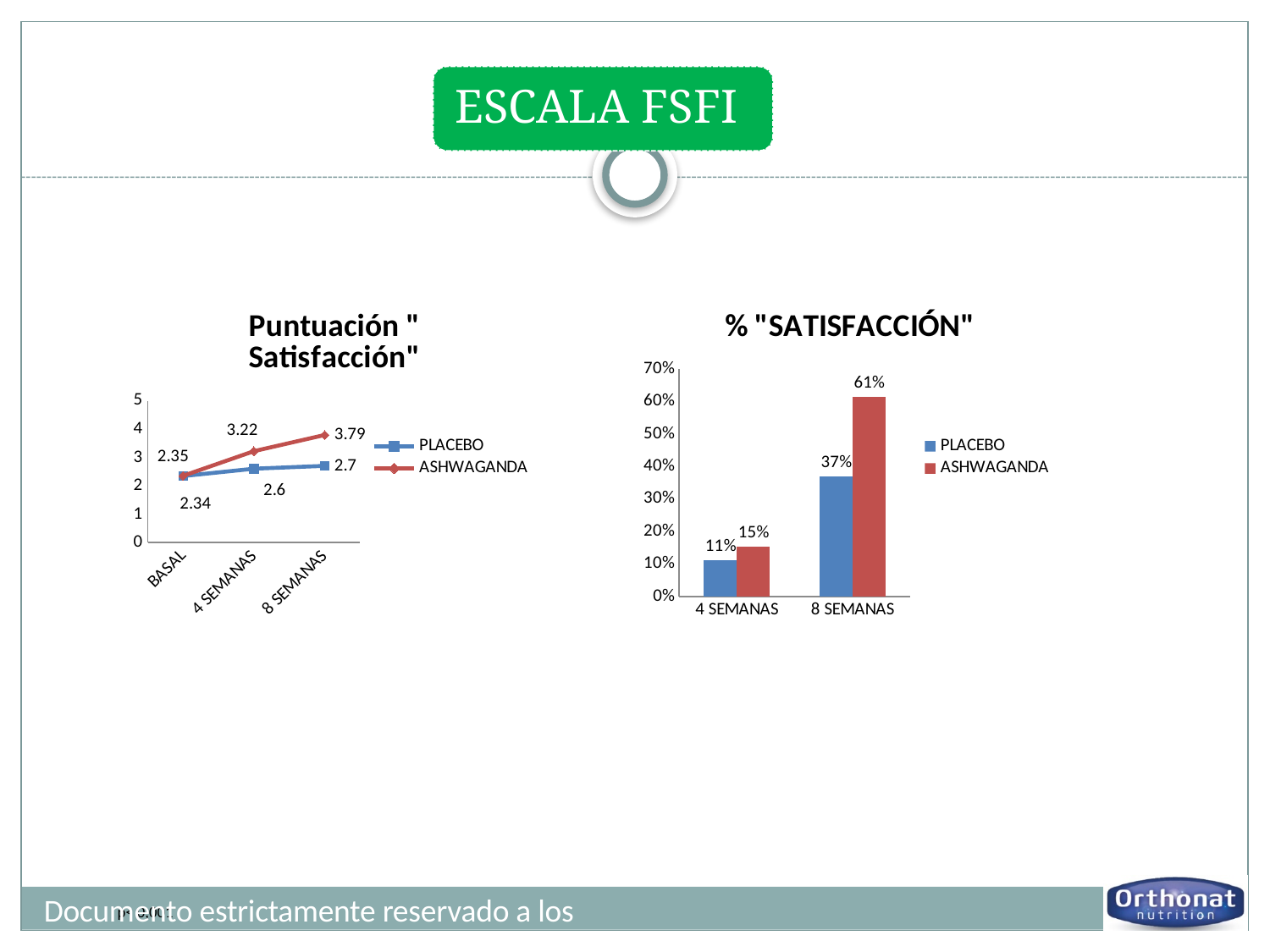
In the chart titled Puntuación "Satisfacción", what kind of chart is shown? Line chart In the chart titled % "SATISFACCIÓN", what kind of chart is shown? Bar chart In the chart titled % "SATISFACCIÓN", how many series does the legend list? 2 In the chart titled Puntuación "Satisfacción", what is the value for ASHWAGANDA at 8 SEMANAS? 3.79 In the chart titled Puntuación "Satisfacción", what is the value for PLACEBO at 4 SEMANAS? 2.6 In the chart titled % "SATISFACCIÓN", what is the difference between ASHWAGANDA and PLACEBO at 8 SEMANAS? 24% In the chart titled % "SATISFACCIÓN", what is the value for PLACEBO at 4 SEMANAS? 11% In the chart titled Puntuación "Satisfacción", how many categories are shown on the x axis? 3 In the chart titled % "SATISFACCIÓN", which series has the higher value at 4 SEMANAS? ASHWAGANDA In the chart titled % "SATISFACCIÓN", what is the value for ASHWAGANDA at 8 SEMANAS? 61% In the chart titled Puntuación "Satisfacción", do the ASHWAGANDA values rise or fall from BASAL to 8 SEMANAS? Rise In the chart titled % "SATISFACCIÓN", how many categories are shown on the x axis? 2